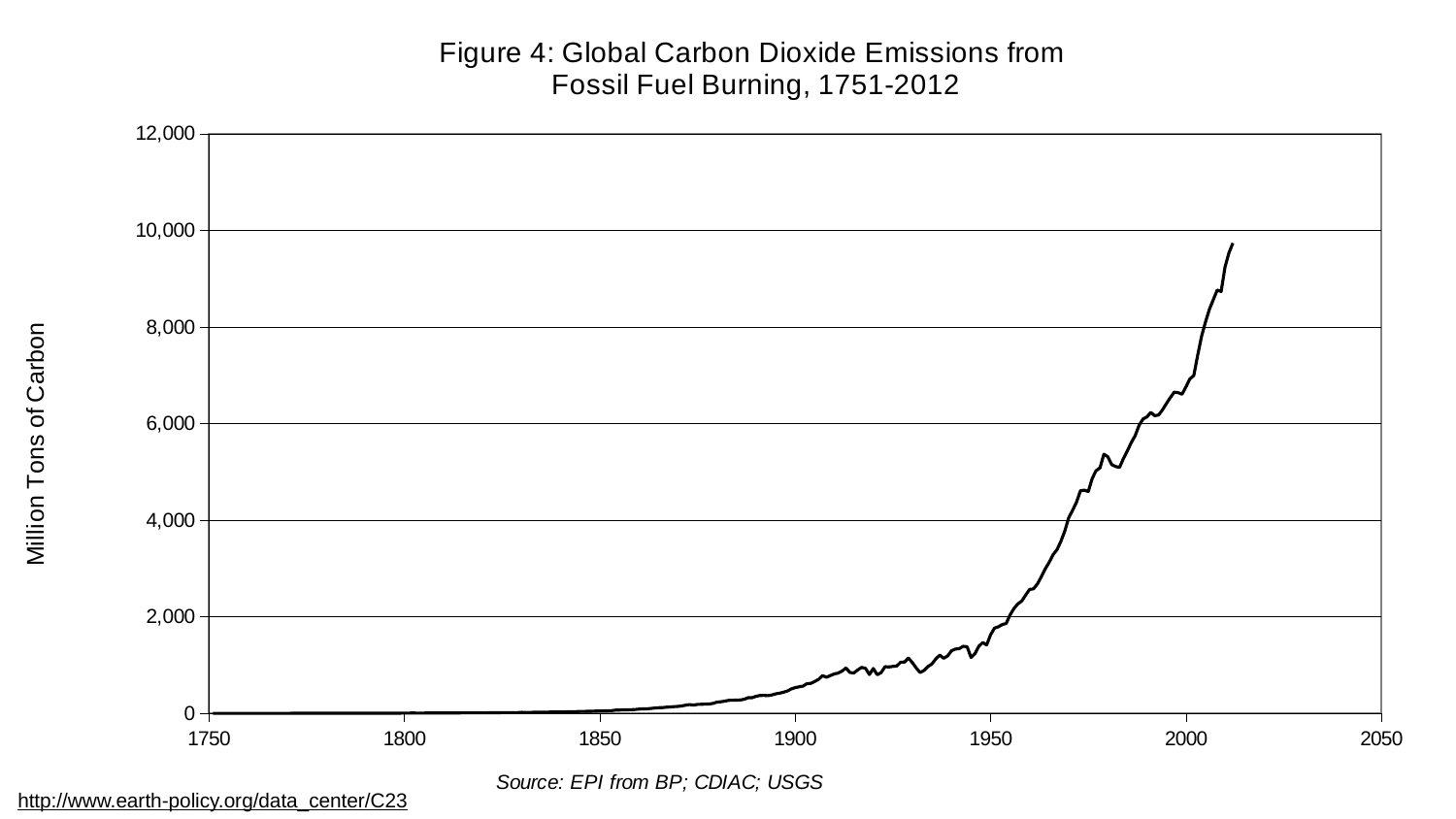
Which year has the higher emissions value, 1950 or 2000? 2000 Do global carbon dioxide emissions rise or fall over the period shown on the x axis? rise Is the value for the year 2000 greater or less than 6,000? greater Is the value for the year 1850 greater or less than 2,000? less Is the value for the year 1900 greater or less than 1,000? less What is the label on the y axis? Million Tons of Carbon At which end of the time period are emissions highest, the start (1751) or the end (2012)? the end (2012) What kind of chart is shown on the slide? line chart What is the title of the chart? Figure 4: Global Carbon Dioxide Emissions from Fossil Fuel Burning, 1751-2012